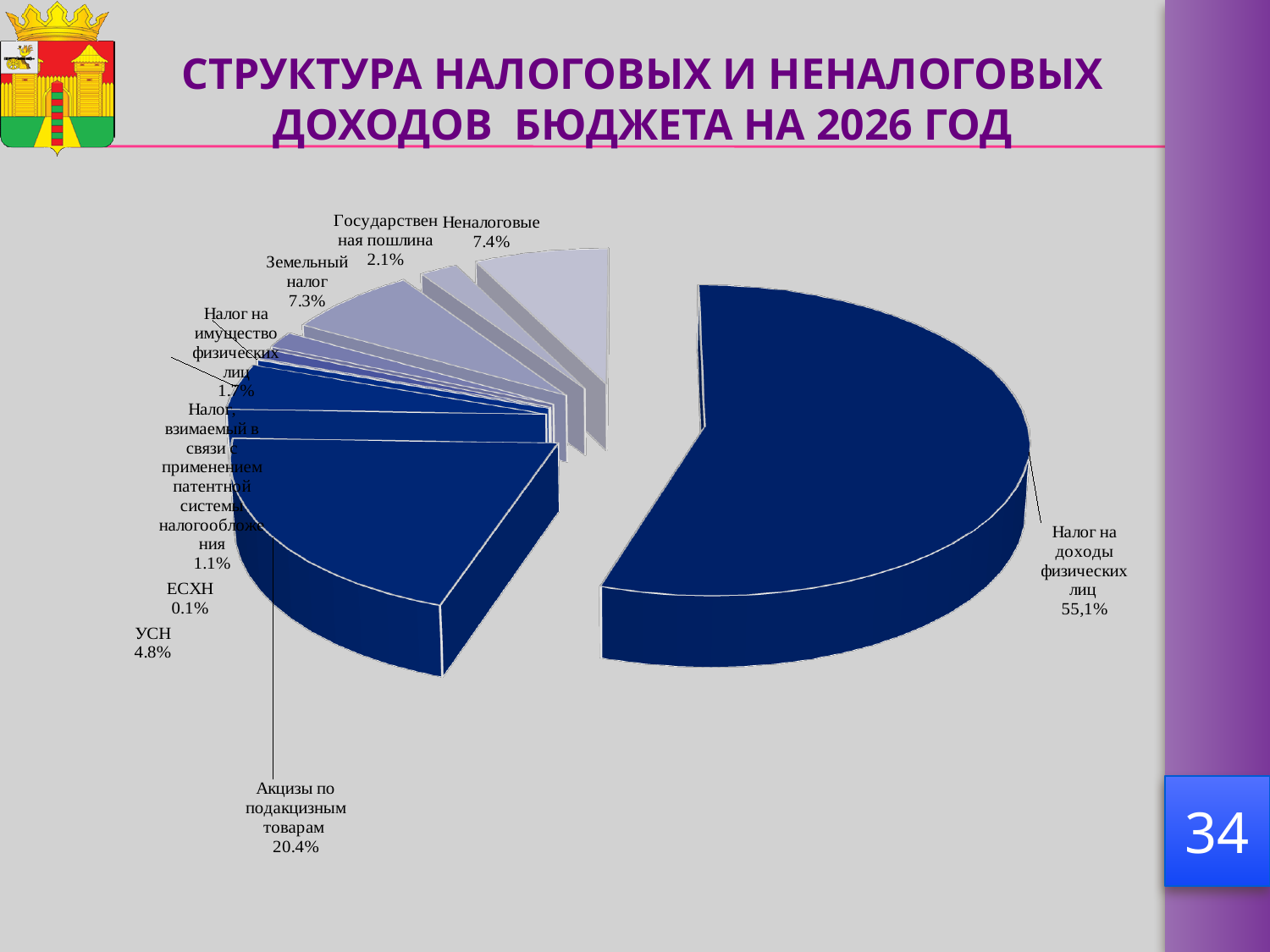
What kind of chart is shown on the slide? pie chart What is the difference between the values for Акцизы по подакцизным товарам and УСН? 15.6% What is the value shown for Земельный налог? 7.3% What is the value shown for Государственная пошлина? 2.1% What is the value shown for Акцизы по подакцизным товарам? 20.4% How many slices does the pie chart have? 9 What is the title of the chart on the slide? СТРУКТУРА НАЛОГОВЫХ И НЕНАЛОГОВЫХ ДОХОДОВ БЮДЖЕТА НА 2026 ГОД What is the value shown for Неналоговые? 7.4% Which category has the largest share of the pie? Налог на доходы физических лиц What share of the pie is Налог на доходы физических лиц? 55,1% Which category has the smallest share of the pie? ЕСХН What is the value shown for УСН? 4.8%